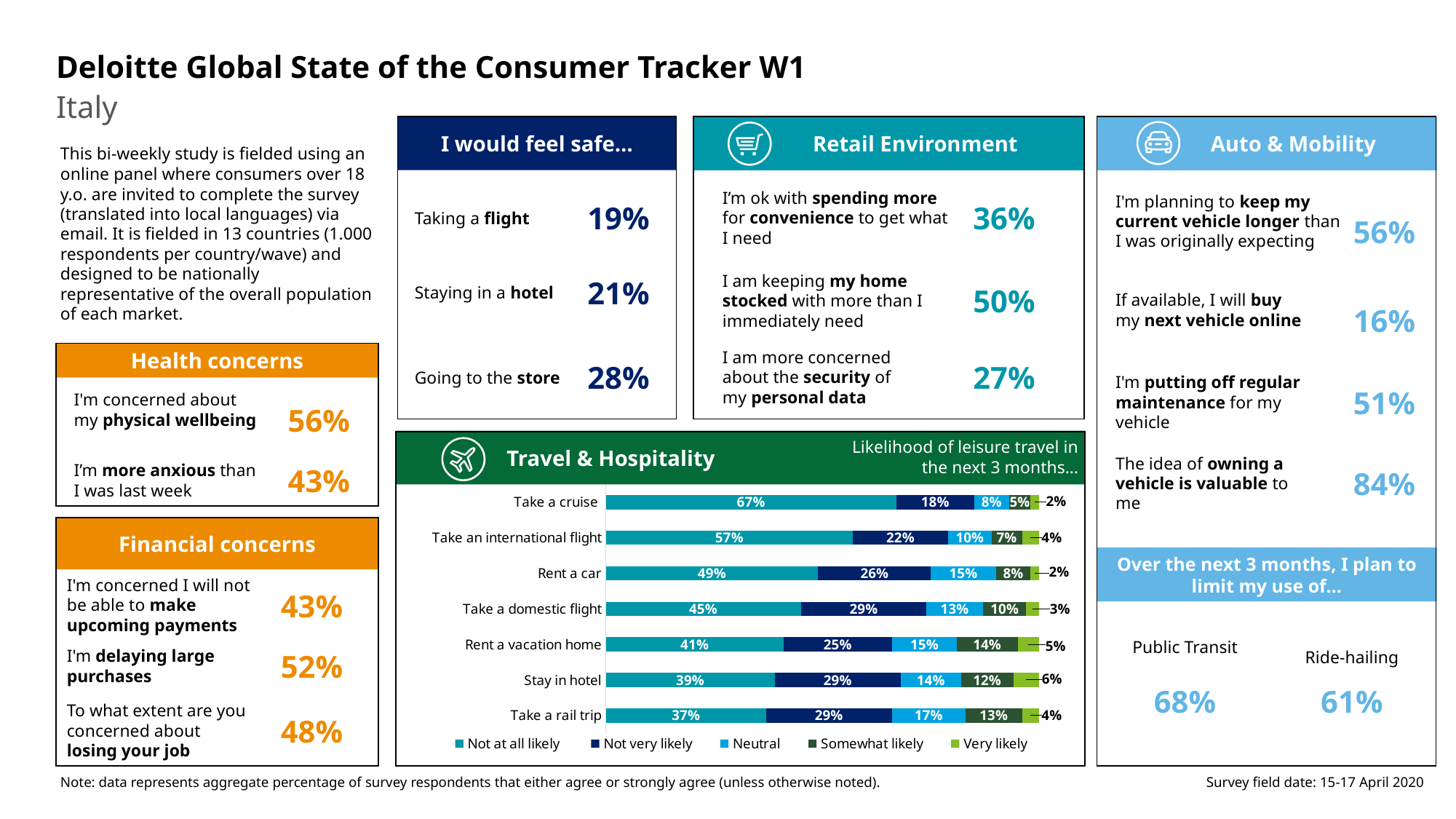
In the Travel & Hospitality chart, what is the 'Very likely' value for 'Stay in hotel'? 6% In the Travel & Hospitality chart, what is the 'Neutral' value for 'Take a rail trip'? 17% In the Travel & Hospitality chart, what is the total of the stacked bar for 'Take a domestic flight'? 100% In the Travel & Hospitality chart, which has a larger 'Somewhat likely' value: 'Rent a vacation home' or 'Rent a car'? Rent a vacation home In the Travel & Hospitality chart, how many activities are listed? 7 In the Travel & Hospitality chart, which activity has the lowest 'Not at all likely' value? Take a rail trip How many series does the legend of the Travel & Hospitality chart list? 5 In the Travel & Hospitality chart, what is the difference between the 'Not at all likely' values for 'Take a cruise' and 'Take a rail trip'? 30% In the Travel & Hospitality chart, what is the 'Not at all likely' value for 'Take a cruise'? 67% What kind of chart is shown in the Travel & Hospitality section? Stacked bar chart In the Travel & Hospitality chart, which activity has the highest 'Not at all likely' value? Take a cruise What is the subtitle shown on the right side of the Travel & Hospitality chart header? Likelihood of leisure travel in the next 3 months...